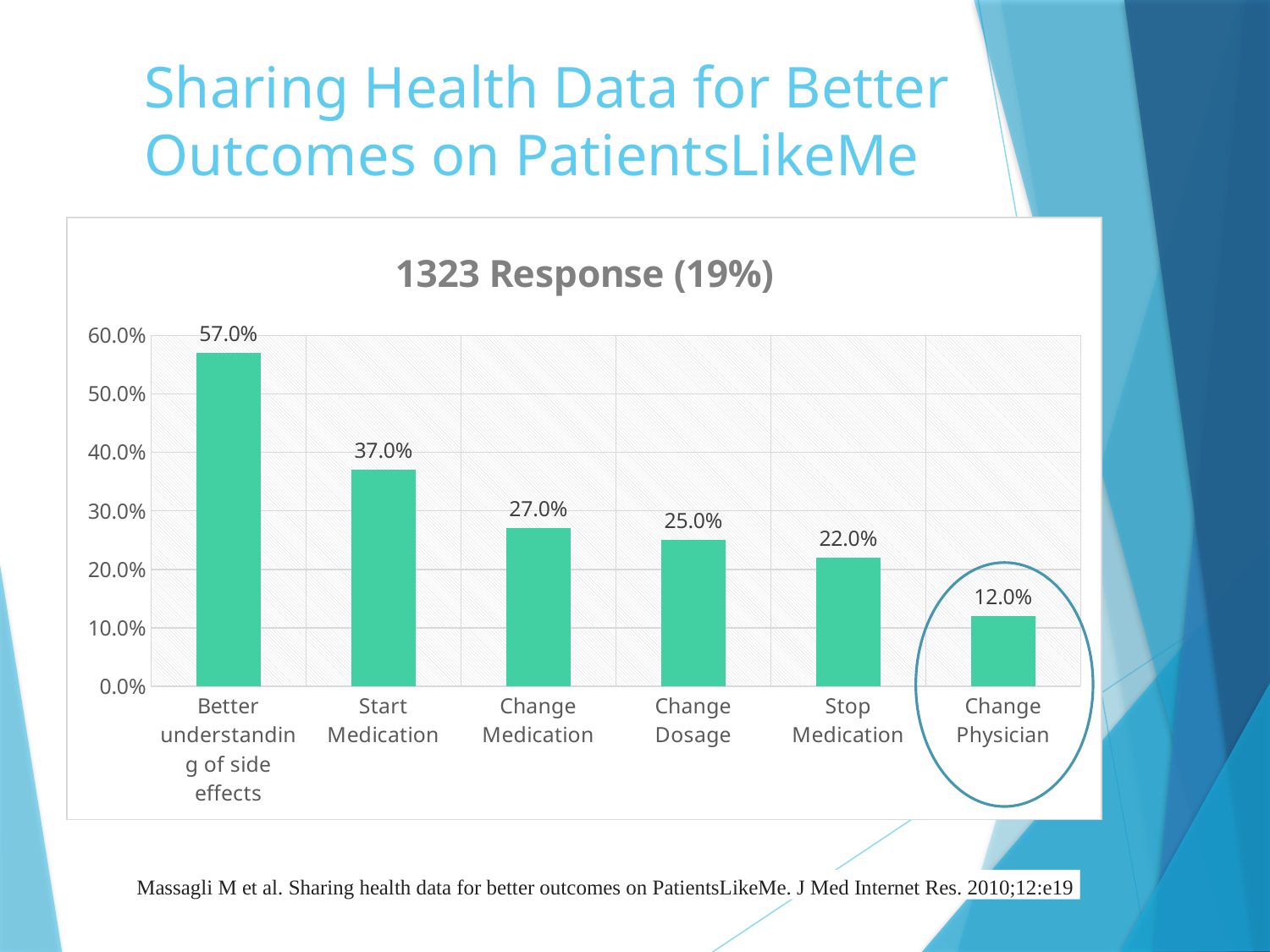
What is the difference between the values for Change Medication and Change Dosage? 2.0% Is the value for Change Medication greater or less than 20.0%? greater What is the value for Start Medication? 37.0% Which is larger, the value for Change Dosage or the value for Stop Medication? Change Dosage What kind of chart is shown on the slide? bar chart What is the value for Stop Medication? 22.0% What is the difference between the values for Better understanding of side effects and Start Medication? 20.0% How many categories are shown on the x axis? 6 Which category has the lowest value? Change Physician What is the title of the chart? 1323 Response (19%) What is the value for Change Physician? 12.0% Which category has the highest value? Better understanding of side effects